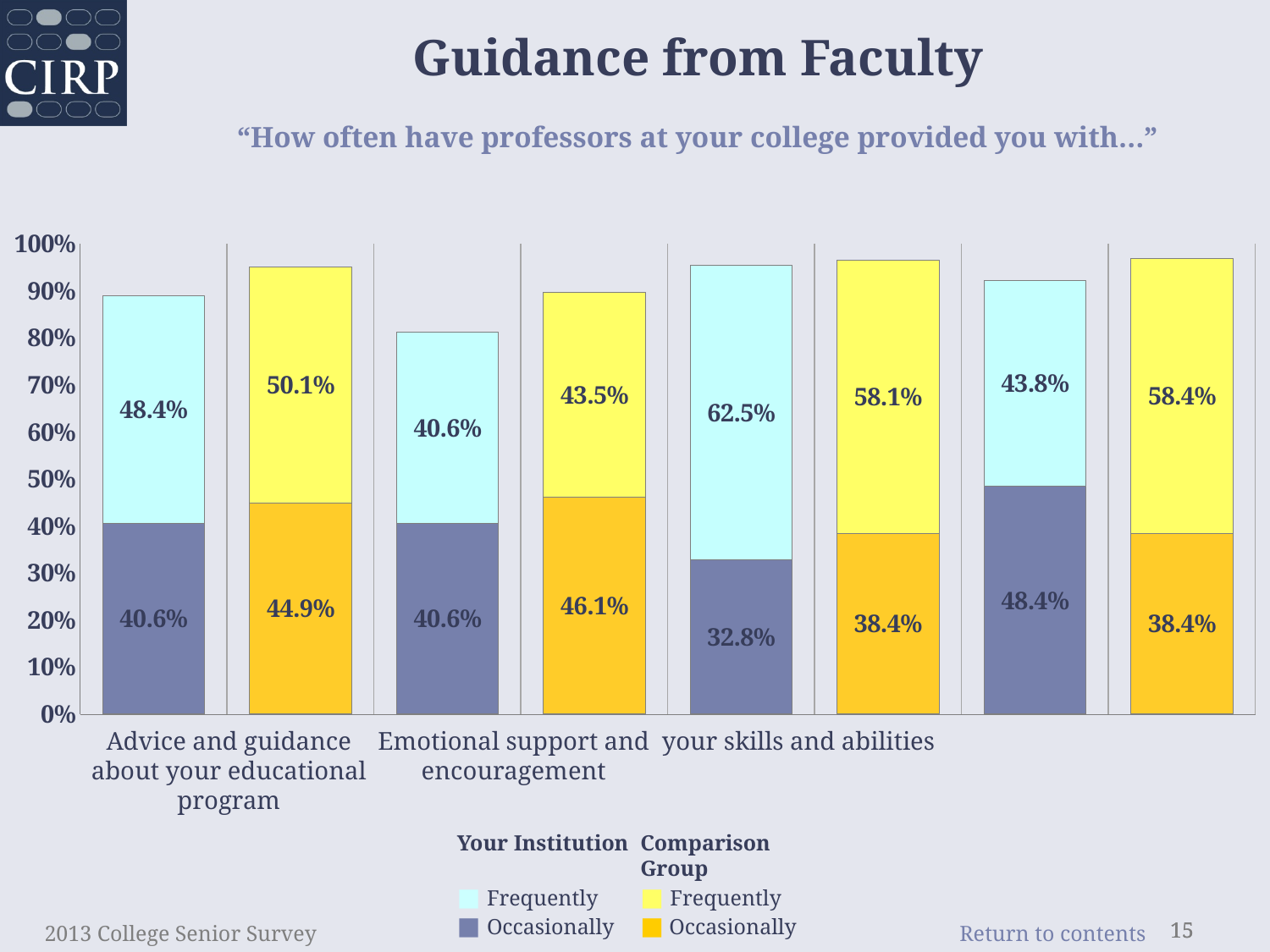
What is the total height of the Your Institution stacked bar for advice and guidance about your educational program? 89.0% What is the total height of the Comparison Group stacked bar for emotional support and encouragement? 89.6% What is the Comparison Group 'Occasionally' value for emotional support and encouragement? 46.1% Which labeled category has the highest Your Institution 'Frequently' value? your skills and abilities For emotional support and encouragement, which Comparison Group response is larger: 'Frequently' or 'Occasionally'? Occasionally What kind of chart is shown on the slide? Stacked bar chart For advice and guidance about your educational program, how much higher is the Comparison Group 'Frequently' value than the Your Institution 'Frequently' value? 1.7 percentage points How many series does the legend list? 4 Which labeled category has the lowest Your Institution 'Occasionally' value? your skills and abilities What is the title of the slide containing the chart? Guidance from Faculty What is the Your Institution 'Occasionally' value for the 'your skills and abilities' category? 32.8% What percentage of Your Institution respondents said professors frequently provided advice and guidance about their educational program? 48.4%